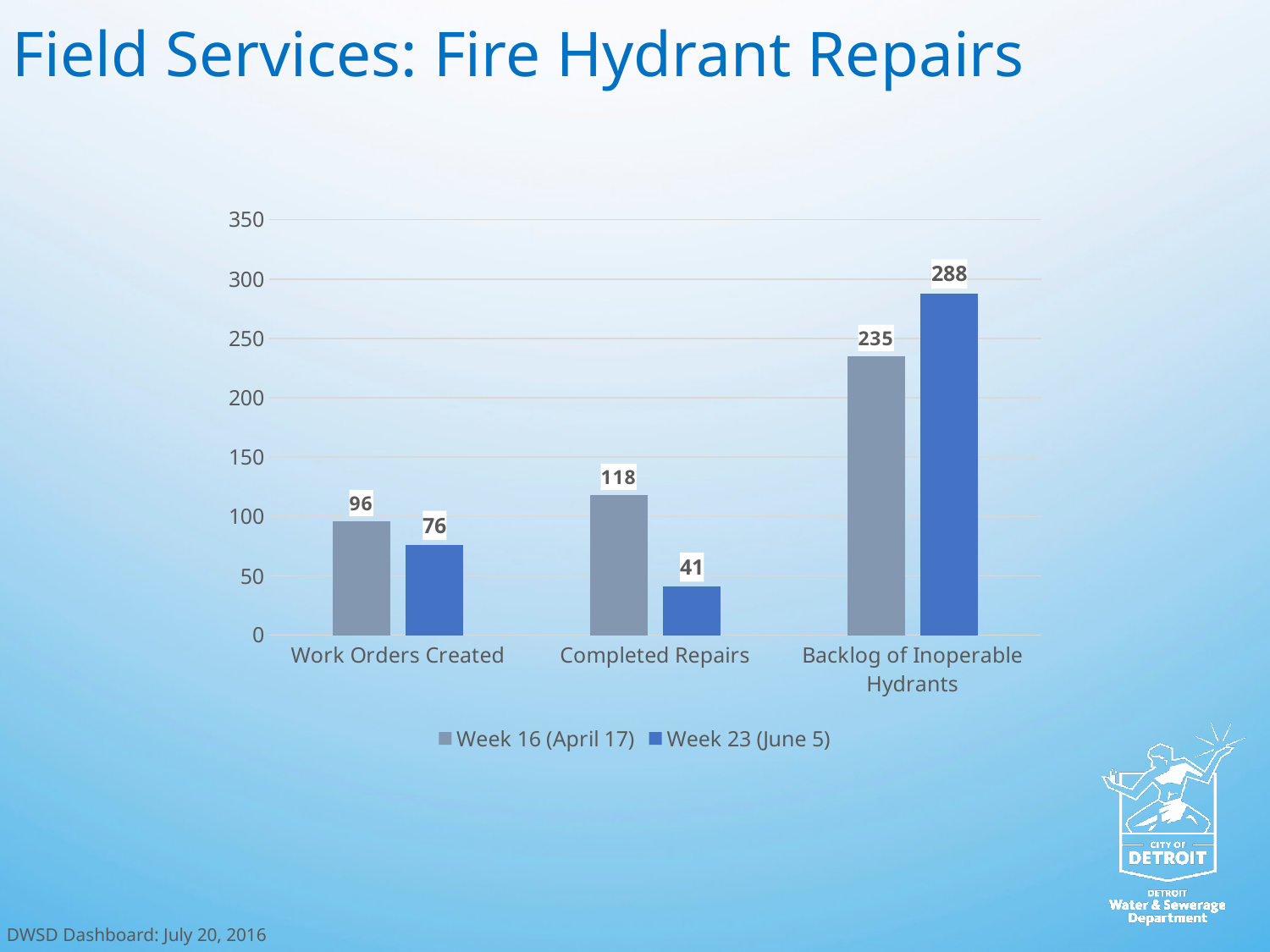
Which category has the highest value in Week 16 (April 17)? Backlog of Inoperable Hydrants What kind of chart is shown on the slide? Bar chart What is the value for Work Orders Created in Week 16 (April 17)? 96 What is the difference between the Week 16 (April 17) and Week 23 (June 5) values for Completed Repairs? 77 Which category has the lowest value in Week 23 (June 5)? Completed Repairs What is the value for Completed Repairs in Week 23 (June 5)? 41 How many series does the legend list? 2 What is the difference between the Week 23 (June 5) and Week 16 (April 17) values for Backlog of Inoperable Hydrants? 53 What is the value for Backlog of Inoperable Hydrants in Week 23 (June 5)? 288 Which is larger for Work Orders Created: Week 16 (April 17) or Week 23 (June 5)? Week 16 (April 17) Is the value for Backlog of Inoperable Hydrants in Week 16 (April 17) greater or less than 200? greater How many categories are shown on the x axis? 3